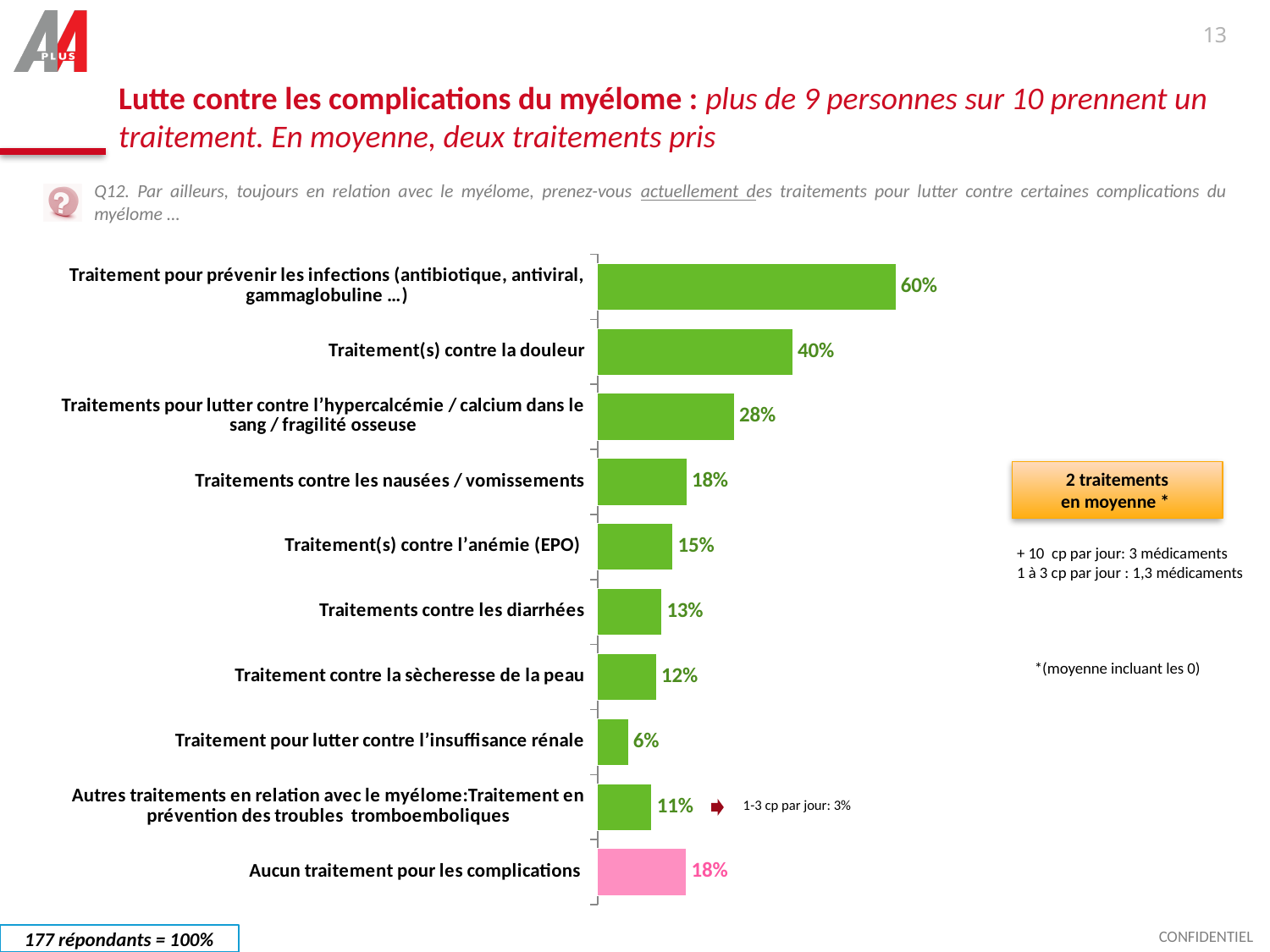
What percentage is shown for "Traitement pour lutter contre l'insuffisance rénale"? 6% Which treatment category has the highest percentage? Traitement pour prévenir les infections (antibiotique, antiviral, gammaglobuline …) What is the difference in percentage points between the treatment to prevent infections and the treatment(s) against pain? 20 percentage points Which category has the lowest percentage in the chart? Traitement pour lutter contre l'insuffisance rénale Which is larger: the value for "Traitement(s) contre la douleur" or for "Traitements pour lutter contre l'hypercalcémie / calcium dans le sang / fragilité osseuse"? Traitement(s) contre la douleur What is the difference between "Traitements contre les nausées / vomissements" and "Traitement(s) contre l'anémie (EPO)"? 3 percentage points What is the value shown for "Traitement(s) contre la douleur"? 40% Which bar is coloured pink instead of green? Aucun traitement pour les complications What is the value for "Aucun traitement pour les complications"? 18% What percentage of respondents take a treatment to prevent infections (antibiotique, antiviral, gammaglobuline …)? 60% What type of chart is used on this slide? Bar chart How many categories (bars) are shown in the chart? 10